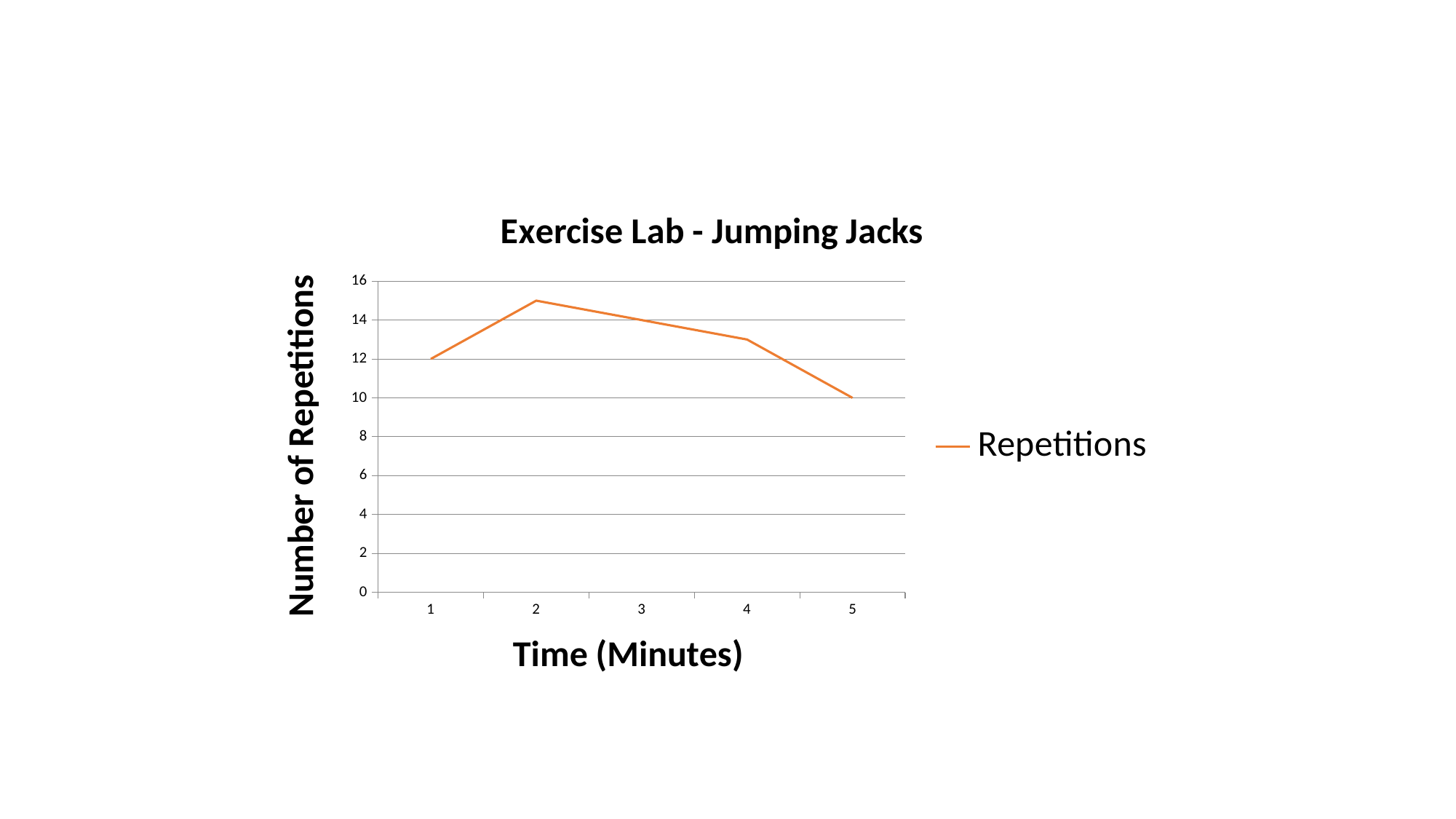
What is the difference in repetitions between minute 1 and minute 5? 2 How many series does the legend list? 1 Is the number of repetitions at minute 2 greater or less than 14? greater At which minute is the number of repetitions lowest? 5 At which minute is the number of repetitions highest? 2 What type of chart is shown on the slide? Line chart What is the title of the chart? Exercise Lab - Jumping Jacks What is the number of repetitions at minute 1? 12 What is the number of repetitions at minute 5? 10 Do the repetitions rise or fall from minute 2 to minute 5? fall How many time points are plotted on the x axis? 5 Is the number of repetitions at minute 4 greater or less than 12? greater